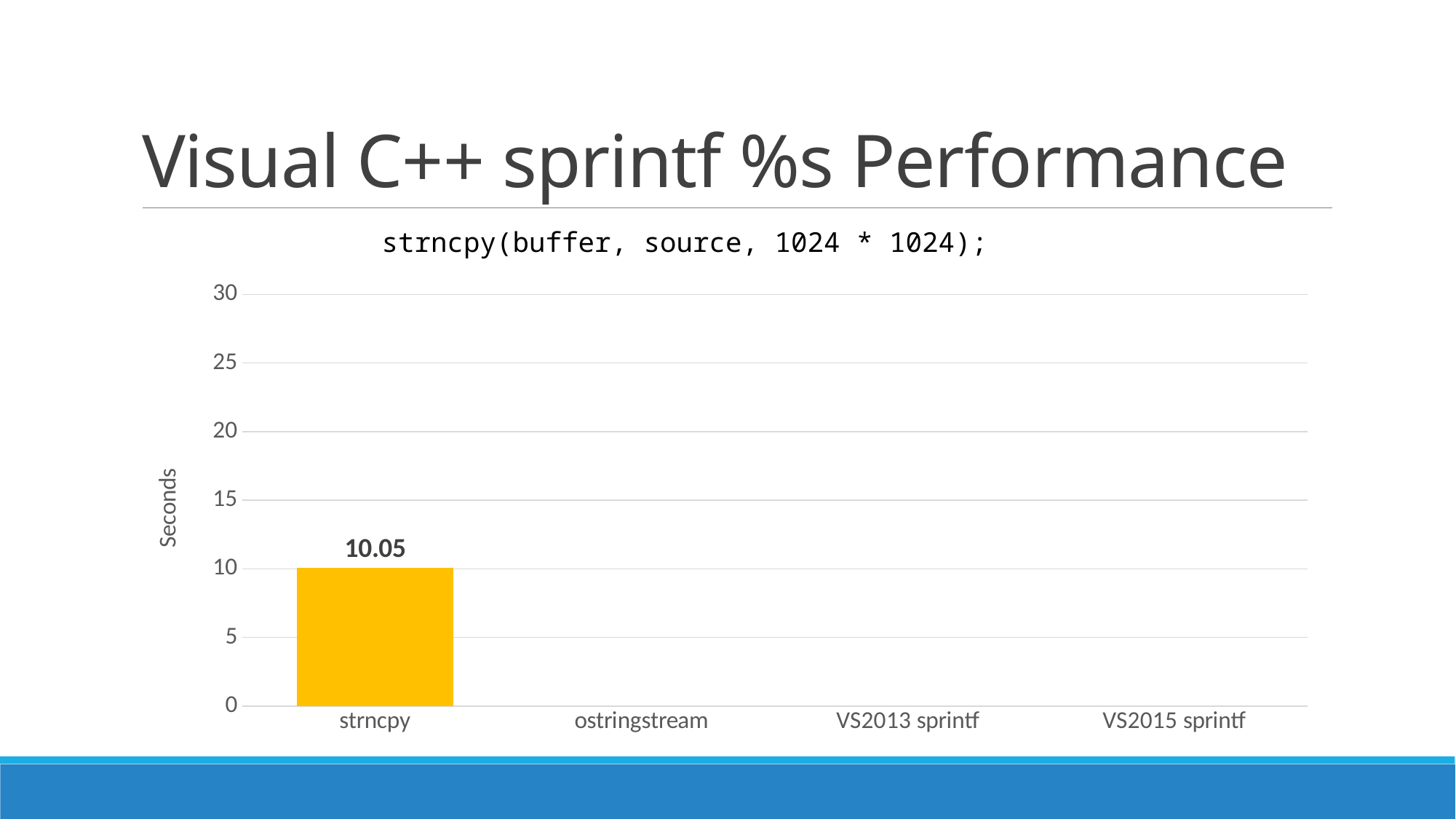
How many categories are labelled on the x axis? 4 What is the label of the last category on the x axis? VS2015 sprintf What is the highest value shown on the vertical axis? 30 How many bars are actually plotted on the chart? 1 What kind of chart is shown on the slide? bar chart Is the value for strncpy greater or less than 15? less What is the value for strncpy? 10.05 What is the label of the vertical axis? Seconds Which category has a bar plotted on the chart? strncpy Is the value for strncpy greater or less than 5? greater